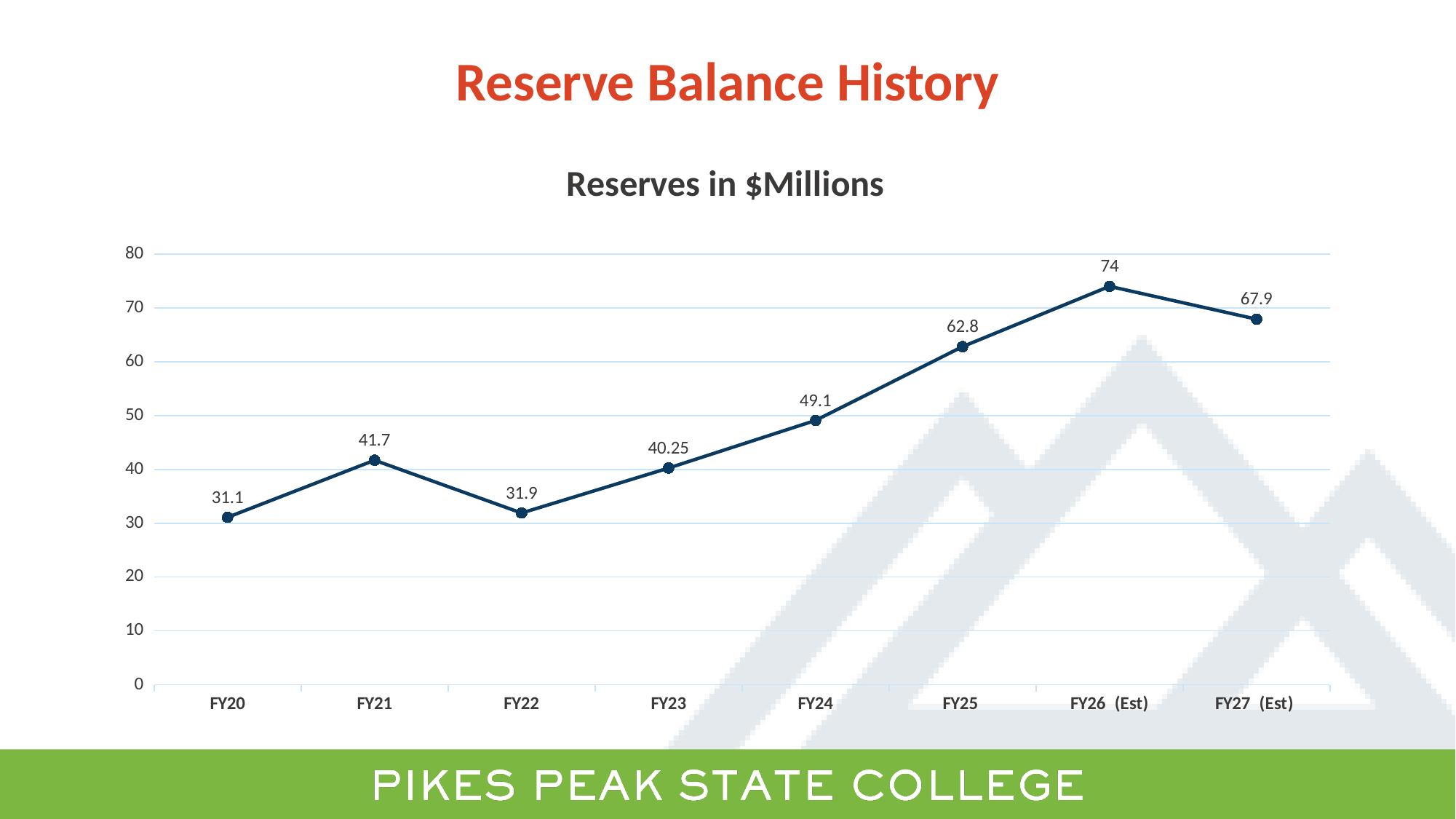
How many fiscal years are plotted on the chart? 8 Which is larger, the reserve balance in FY24 or FY23? FY24 What is the title of the chart? Reserves in $Millions Is the reserve balance for FY24 greater or less than 40? greater Which fiscal year has the lowest reserve balance? FY20 What is the difference between the reserve balance in FY26 (Est) and FY25? 11.2 What kind of chart is shown on the slide? Line chart What is the estimated reserve balance for FY27 (Est)? 67.9 What is the reserve balance for FY25? 62.8 What is the difference between the reserve balance in FY21 and FY22? 9.8 What is the reserve balance for FY23? 40.25 Which fiscal year has the highest reserve balance? FY26 (Est)